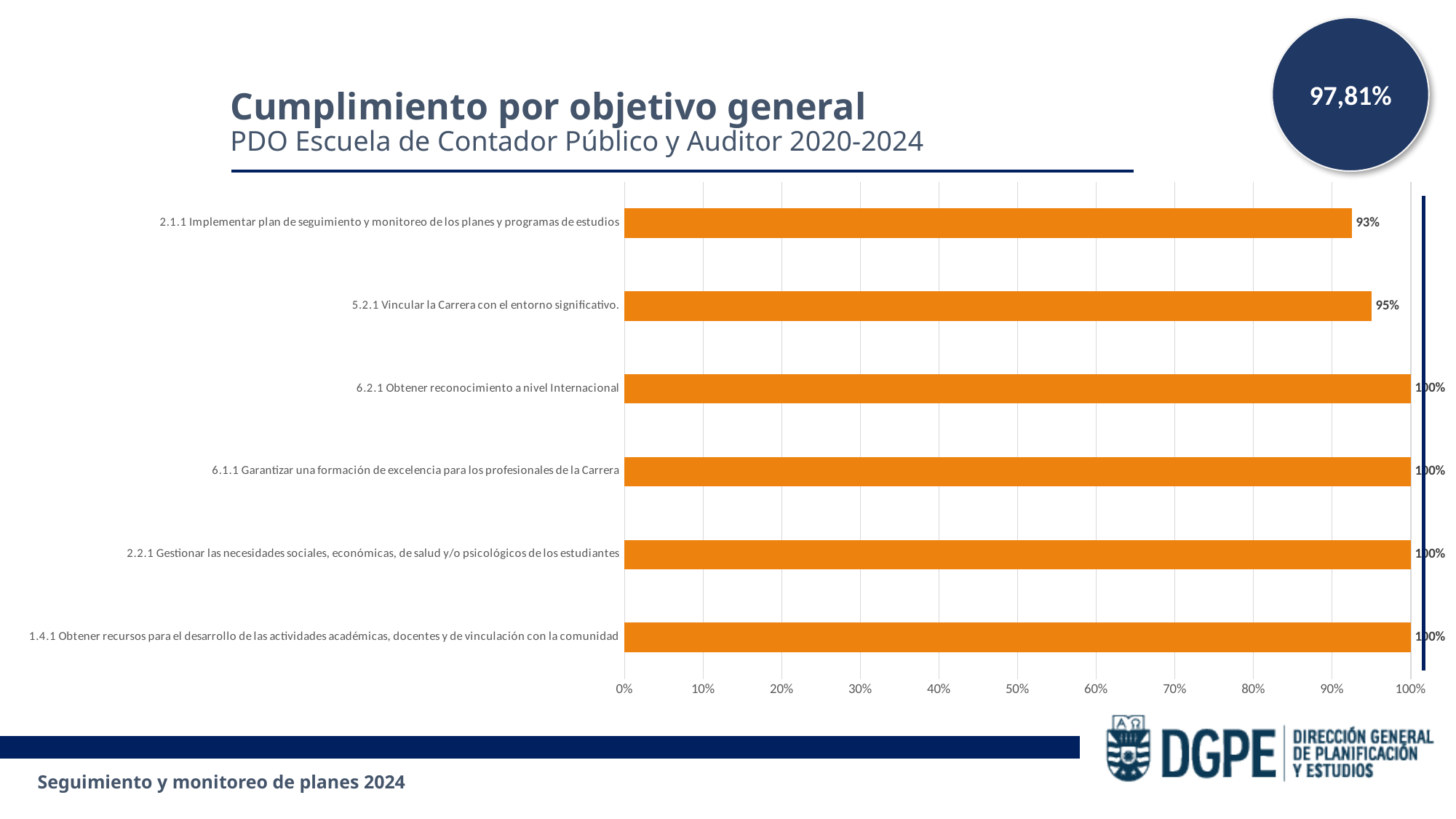
How many objectives are shown in the chart? 6 What kind of chart is shown on the slide? Bar chart What overall percentage is shown in the circle at the top right of the slide? 97,81% What is the value for 5.2.1 Vincular la Carrera con el entorno significativo? 95% What is the value for 6.2.1 Obtener reconocimiento a nivel Internacional? 100% Is the value for 2.1.1 Implementar plan de seguimiento y monitoreo de los planes y programas de estudios greater or less than 90%? greater What is the value for 2.1.1 Implementar plan de seguimiento y monitoreo de los planes y programas de estudios? 93% Which objective has the lowest value? 2.1.1 Implementar plan de seguimiento y monitoreo de los planes y programas de estudios Which is larger, the value for 5.2.1 Vincular la Carrera con el entorno significativo or the value for 2.1.1 Implementar plan de seguimiento y monitoreo de los planes y programas de estudios? 5.2.1 Vincular la Carrera con el entorno significativo What is the title of the chart? Cumplimiento por objetivo general What is the difference between the values for 5.2.1 Vincular la Carrera con el entorno significativo and 2.1.1 Implementar plan de seguimiento y monitoreo de los planes y programas de estudios? 2% How many objectives have a value of 100%? 4